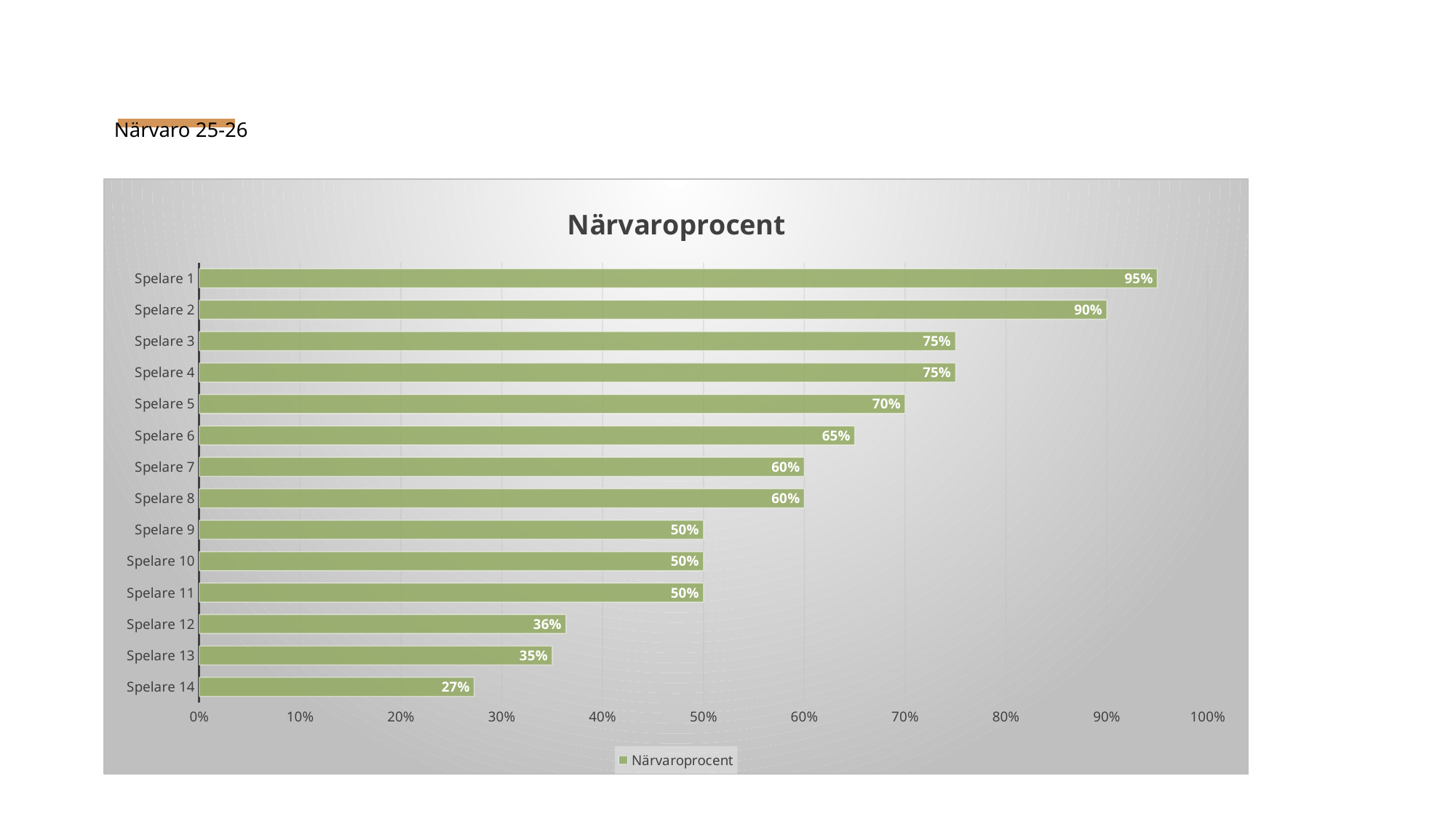
What kind of chart is shown on the slide? Bar chart How many players are shown in the chart? 14 What is the difference between the values for Spelare 6 and Spelare 14? 38% What is the attendance percentage for Spelare 5? 70% Which player has the highest attendance percentage? Spelare 1 Is the value for Spelare 13 greater or less than 40%? less What is the difference between the values for Spelare 1 and Spelare 2? 5% Which player has the lowest attendance percentage? Spelare 14 How many series does the legend list? 1 What is the title of the chart? Närvaroprocent Which has a larger value, Spelare 3 or Spelare 7? Spelare 3 What is the value shown for Spelare 12? 36%